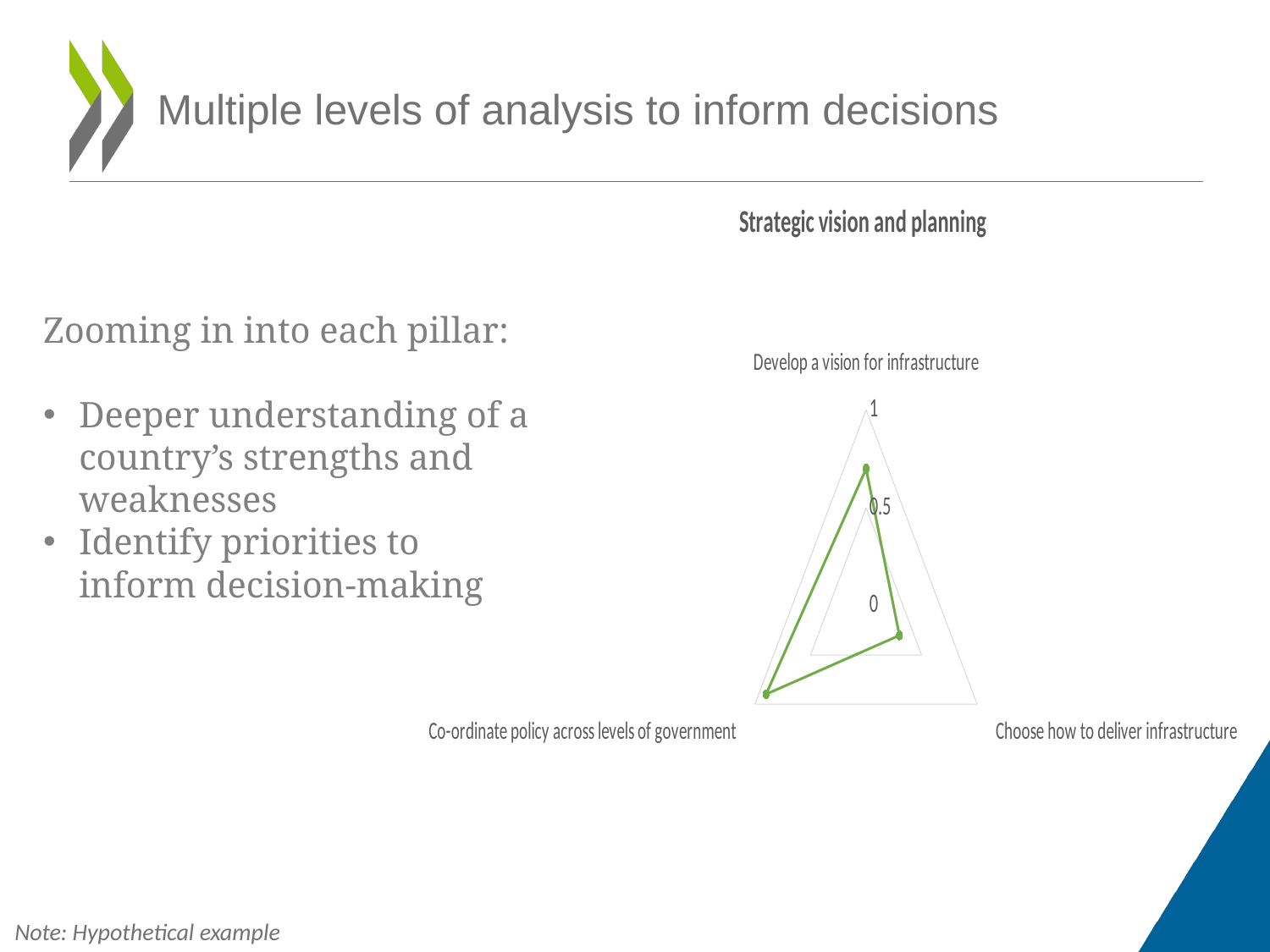
Which category has the highest value on the radar chart? Co-ordinate policy across levels of government Which is larger: the value for Develop a vision for infrastructure or the value for Choose how to deliver infrastructure? Develop a vision for infrastructure What is the title of the chart? Strategic vision and planning How many categories (axes) does the radar chart have? 3 What kind of chart is shown on the slide? Radar chart Is the value for Co-ordinate policy across levels of government greater or less than 0.5? greater Which category has the lowest value on the radar chart? Choose how to deliver infrastructure What is the maximum value shown on the radar chart's axis scale? 1 Is the value for Choose how to deliver infrastructure greater or less than 0.5? less Which is larger: the value for Co-ordinate policy across levels of government or the value for Develop a vision for infrastructure? Co-ordinate policy across levels of government Is the value for Develop a vision for infrastructure greater or less than 0.5? greater